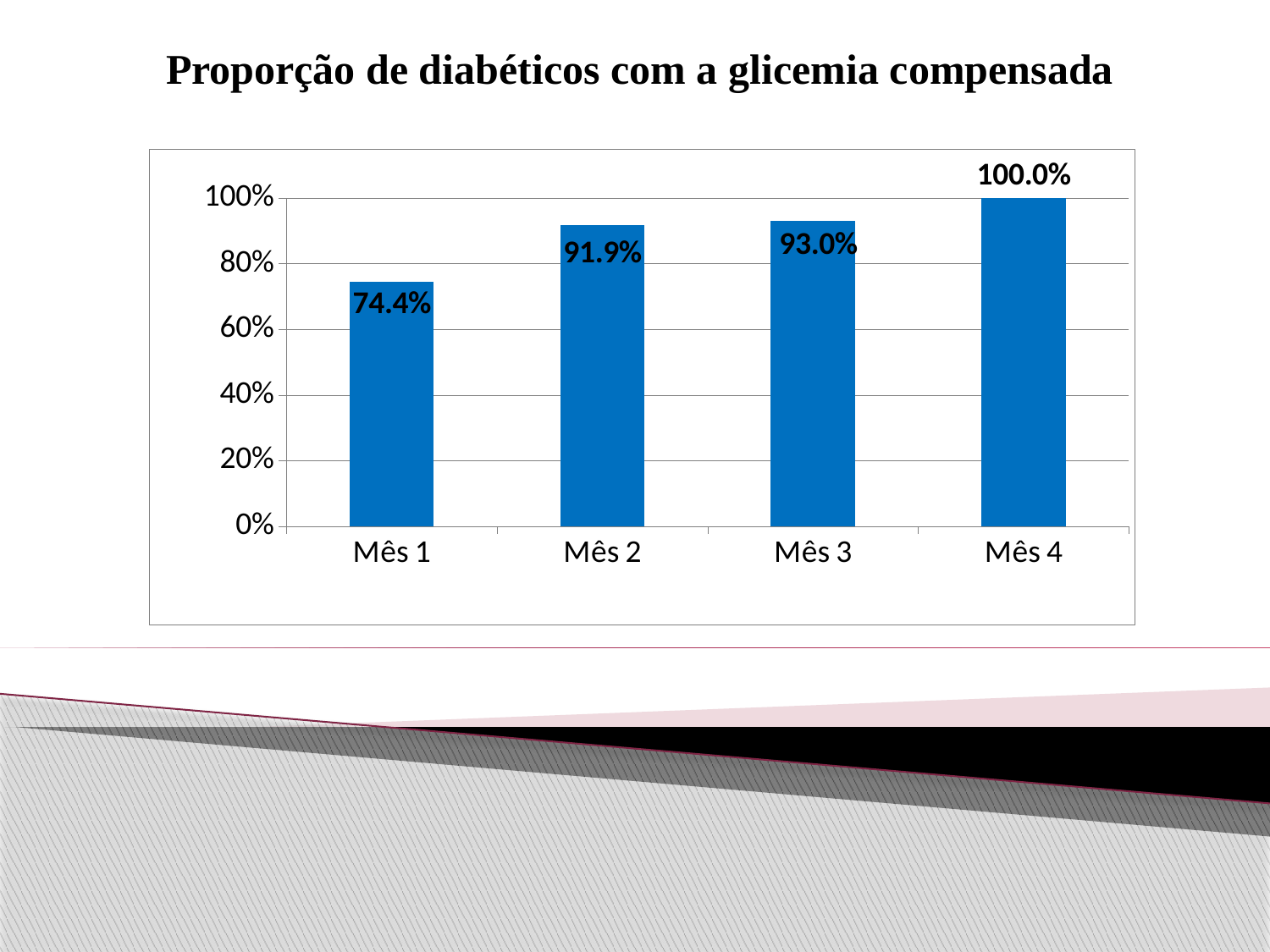
What is the value for Mês 2? 91.9% Do the values rise or fall from Mês 1 to Mês 4? Rise What is the value for Mês 1? 74.4% What is the difference between the values for Mês 4 and Mês 1? 25.6% How many months are shown on the x axis? 4 What is the difference between the values for Mês 3 and Mês 2? 1.1% Which month has the lowest value? Mês 1 What is the value for Mês 3? 93.0% Which month has the highest value? Mês 4 What is the value for Mês 4? 100.0% Which is larger, the value for Mês 1 or the value for Mês 2? Mês 2 What kind of chart is shown on the slide? Bar chart